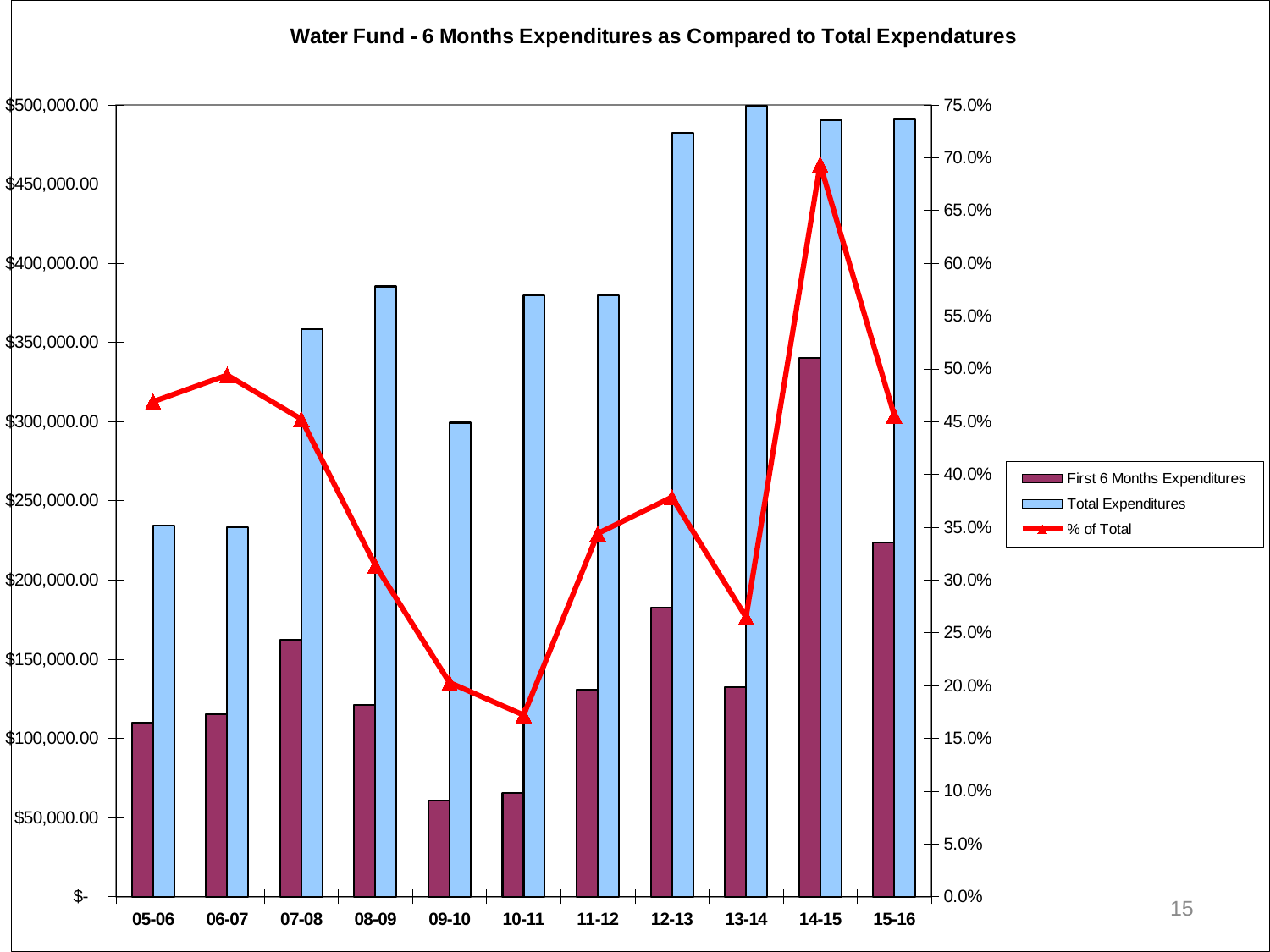
Which fiscal year has the highest First 6 Months Expenditures? 14-15 What is the title of the chart? Water Fund - 6 Months Expenditures as Compared to Total Expendatures Which fiscal year has the lowest % of Total? 10-11 How many series does the legend list? 3 How many fiscal years are shown on the x axis? 11 Is the First 6 Months Expenditures value for 14-15 greater or less than $300,000.00? greater Is the First 6 Months Expenditures value for 09-10 greater or less than $100,000.00? less Does the % of Total line rise or fall from 06-07 to 10-11? fall Which fiscal year has the highest % of Total? 14-15 Which has the larger First 6 Months Expenditures, 07-08 or 08-09? 07-08 Is the Total Expenditures value for 12-13 greater or less than $450,000.00? greater What kind of chart is this? Combined bar and line chart